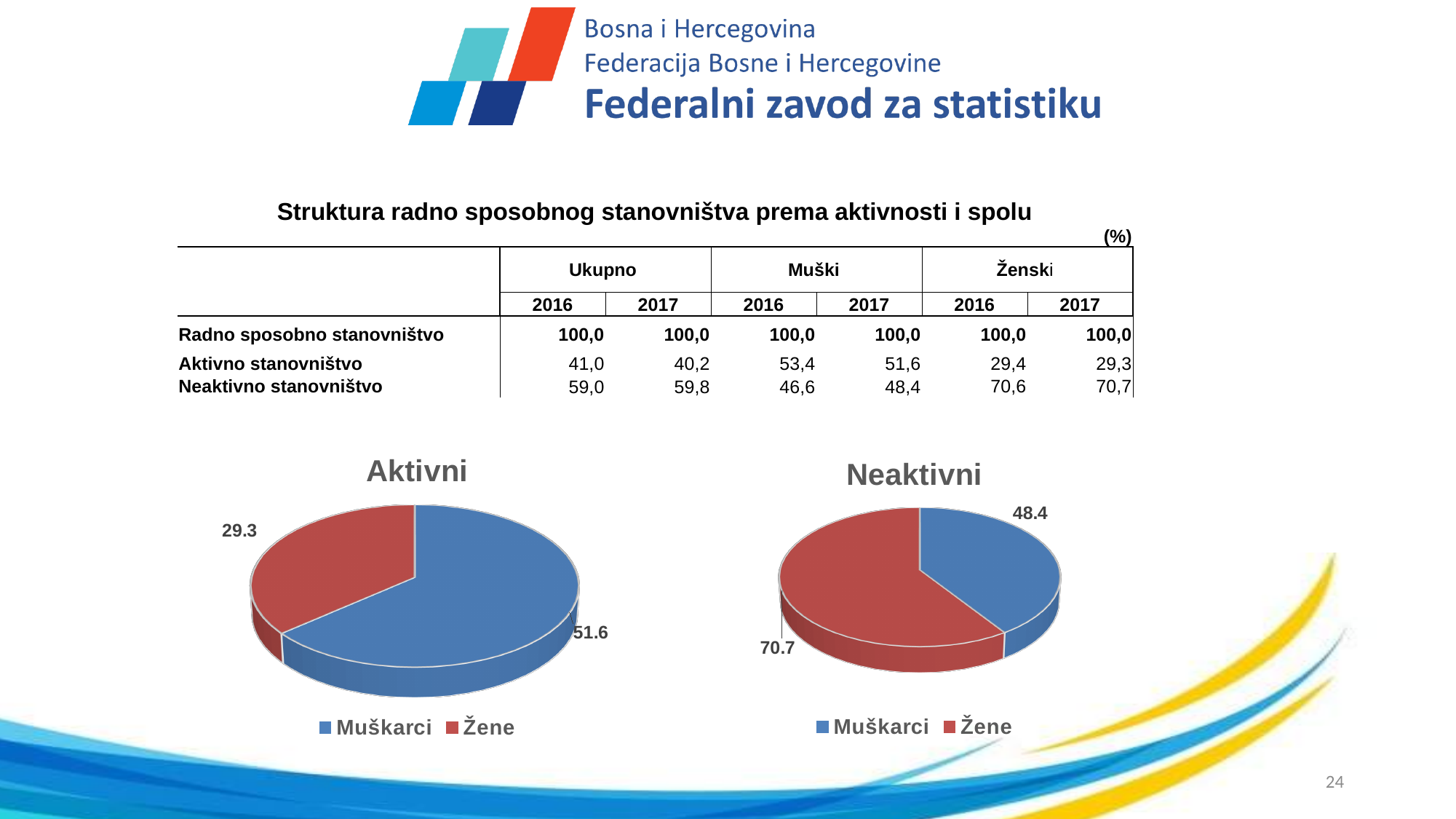
In the Neaktivni chart, what is the value for Žene? 70.7 In the Aktivni chart, what is the difference between the Muškarci and Žene values? 22.3 In the Aktivni chart, what is the value for Muškarci? 51.6 What colour is the Žene slice in the Aktivni chart? Red How many slices does the Neaktivni chart have? 2 What kind of chart is the Aktivni chart? Pie chart In the Aktivni chart, which category has the larger slice? Muškarci In the Neaktivni chart, which is larger, Muškarci or Žene? Žene In the Neaktivni chart, which category has the smaller slice? Muškarci In the Neaktivni chart, what is the value for Muškarci? 48.4 In the Aktivni chart, what is the value for Žene? 29.3 In the Neaktivni chart, what is the difference between the Žene and Muškarci values? 22.3